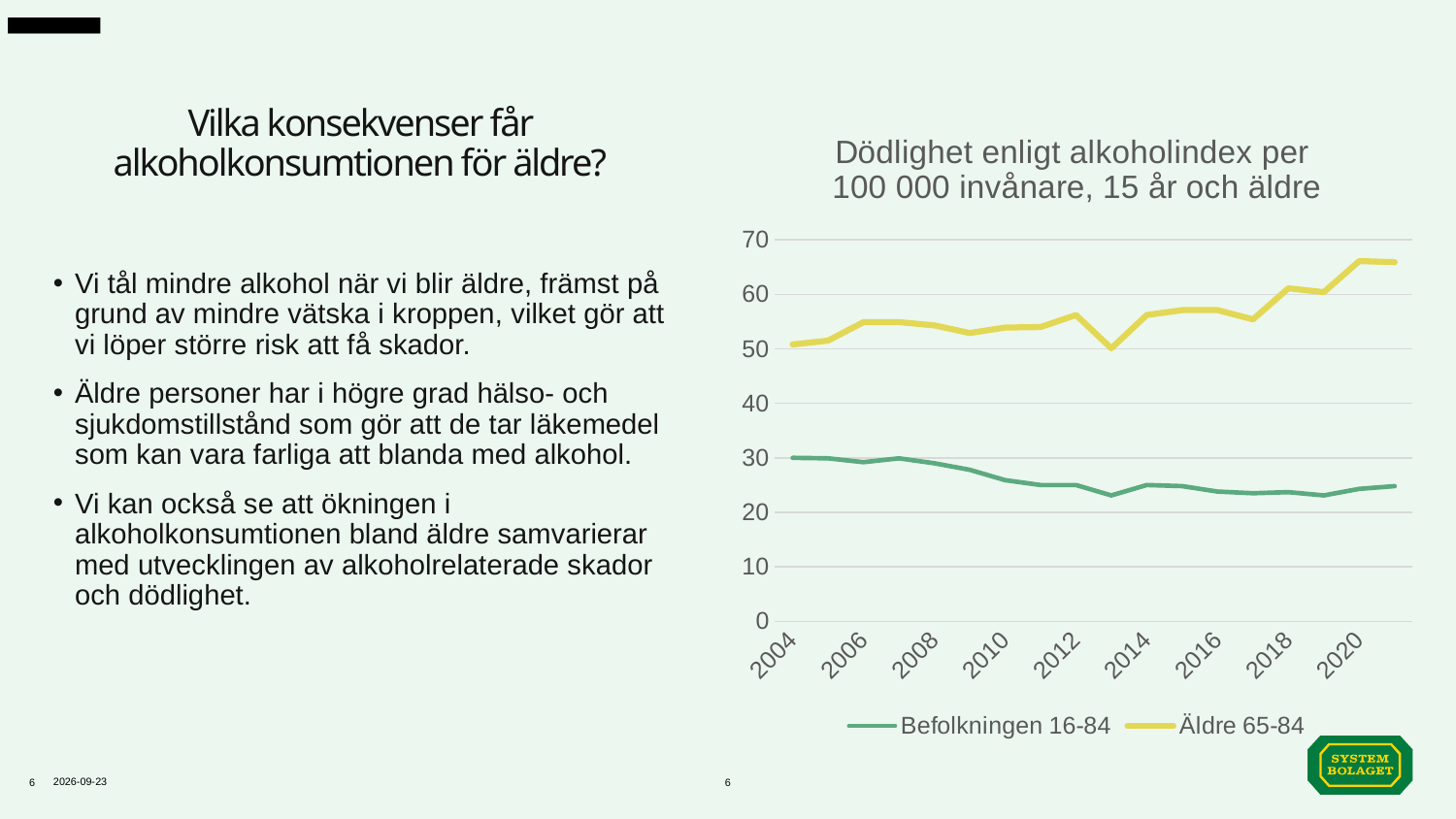
How many series does the chart legend list? 2 Is the value for Äldre 65-84 in 2020 greater or less than 60? greater Which series has the higher value in 2020, Befolkningen 16-84 or Äldre 65-84? Äldre 65-84 Is the value for Befolkningen 16-84 in 2020 greater or less than 30? less Which series reaches the highest value on the chart? Äldre 65-84 Is the value for Äldre 65-84 in 2008 greater or less than 50? greater What is the title of the chart? Dödlighet enligt alkoholindex per 100 000 invånare, 15 år och äldre What kind of chart is shown on the slide? line chart Which two series are listed in the chart legend? Befolkningen 16-84 and Äldre 65-84 Does the Äldre 65-84 line generally rise or fall from 2004 to 2020? rise Does the Befolkningen 16-84 line generally rise or fall from 2004 to 2020? fall